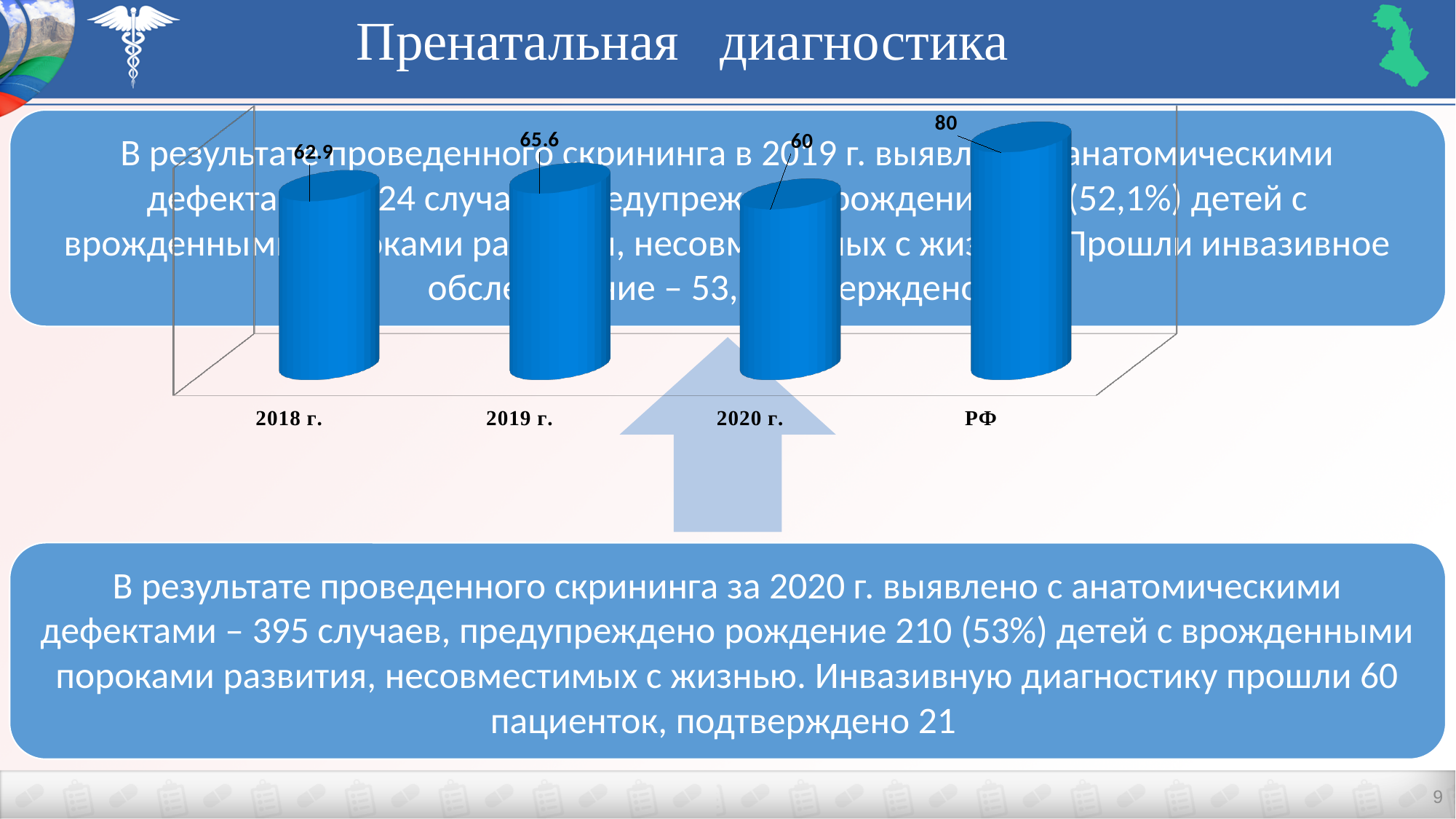
What is the difference between the value for РФ and the value for 2020 г.? 20 What is the value shown for 2018 г.? 62.9 Do the values rise or fall from 2019 г. to 2020 г.? Fall What is the value shown for РФ? 80 What is the value shown for 2020 г.? 60 Which category has the lowest value? 2020 г. What kind of chart is shown on the slide? Bar chart How many categories are shown on the chart? 4 What is the value shown for 2019 г.? 65.6 What is the difference between the value for 2019 г. and the value for 2018 г.? 2.7 Which category has the highest value? РФ Which is larger, the value for 2018 г. or the value for 2020 г.? 2018 г.